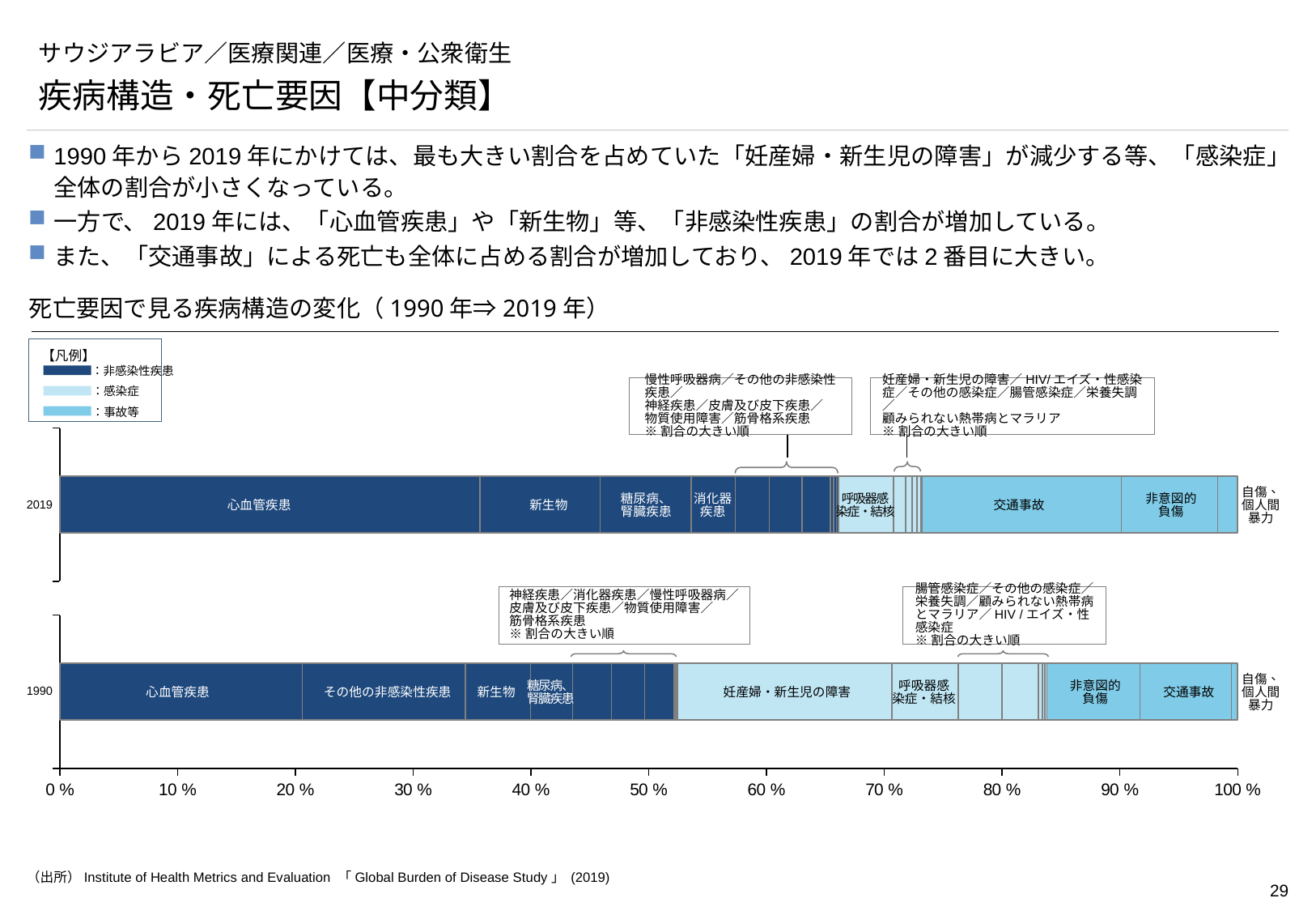
What kind of chart is shown on the slide? Stacked bar chart Is the share of 妊産婦・新生児の障害 in 1990 greater or less than 10%? greater Is the share of 心血管疾患 in 1990 greater or less than 30%? less How many years (bars) does the chart compare? 2 How many categories does the legend (凡例) list? 3 Which legend category is shown in the darkest blue? 非感染性疾患 What is the title of the chart? 死亡要因で見る疾病構造の変化（1990年⇒2019年） Which is larger: the share of 心血管疾患 in 2019 or in 1990? 2019 Is the share of 心血管疾患 in 2019 greater or less than 30%? greater Which segment is the largest in the 2019 bar? 心血管疾患 In the 2019 bar, which is larger: 心血管疾患 or 新生物? 心血管疾患 In the 1990 bar, which is larger: 妊産婦・新生児の障害 or 交通事故? 妊産婦・新生児の障害